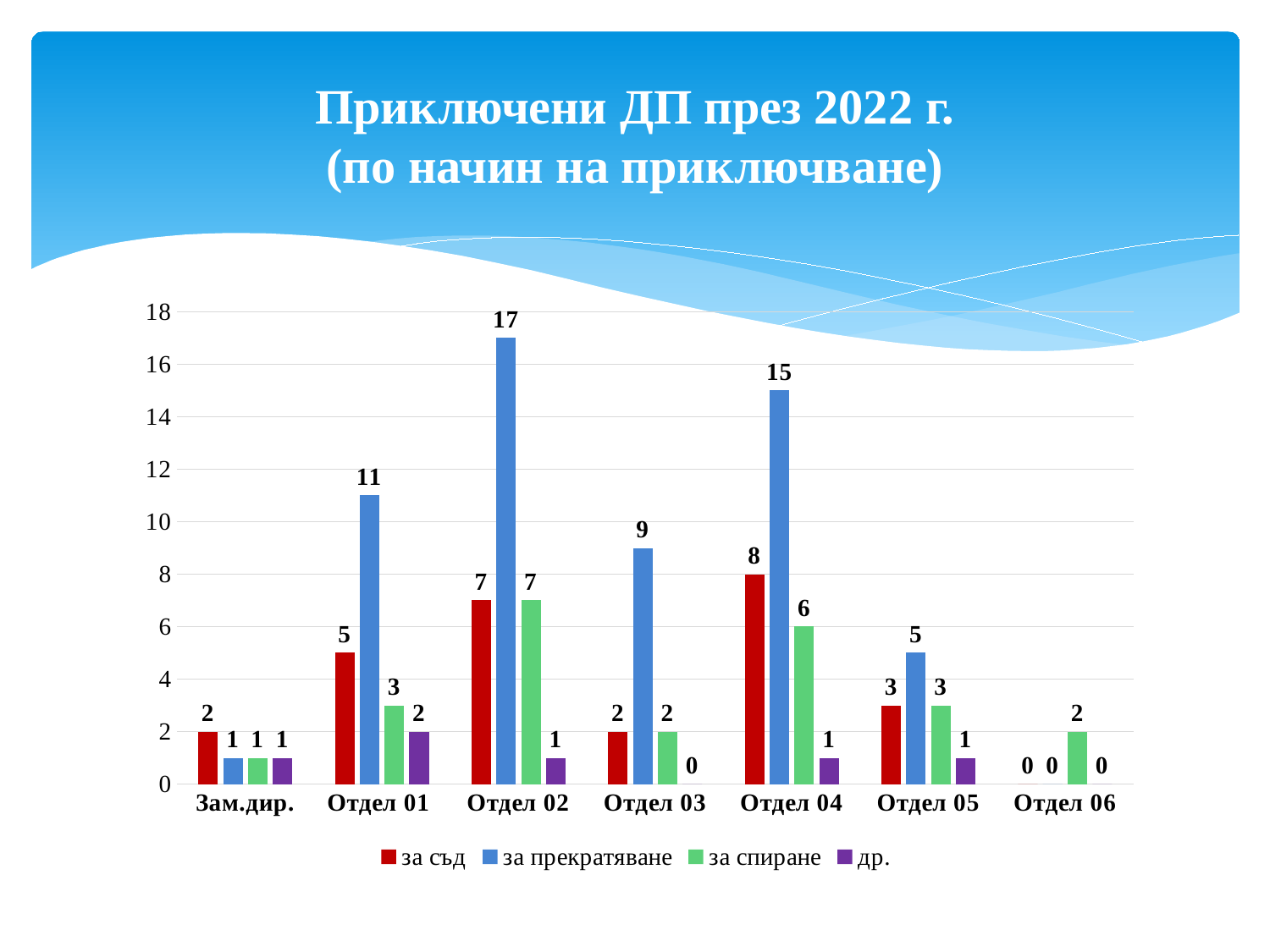
Which category has the lowest value for "за съд"? Отдел 06 Which is larger: "за съд" for Отдел 02 or "за съд" for Отдел 04? Отдел 04 What is the title of the chart? Приключени ДП през 2022 г. (по начин на приключване) What is the value of "за спиране" for Отдел 06? 2 What is the difference between the "за прекратяване" values for Отдел 02 and Отдел 04? 2 How many categories are shown on the x axis? 7 What is the value of "за съд" for Отдел 04? 8 What is the value of "др." for Отдел 01? 2 What is the value of "за прекратяване" for Отдел 02? 17 How many series does the legend list? 4 Which category has the highest value for "за прекратяване"? Отдел 02 What kind of chart is shown on the slide? Bar chart